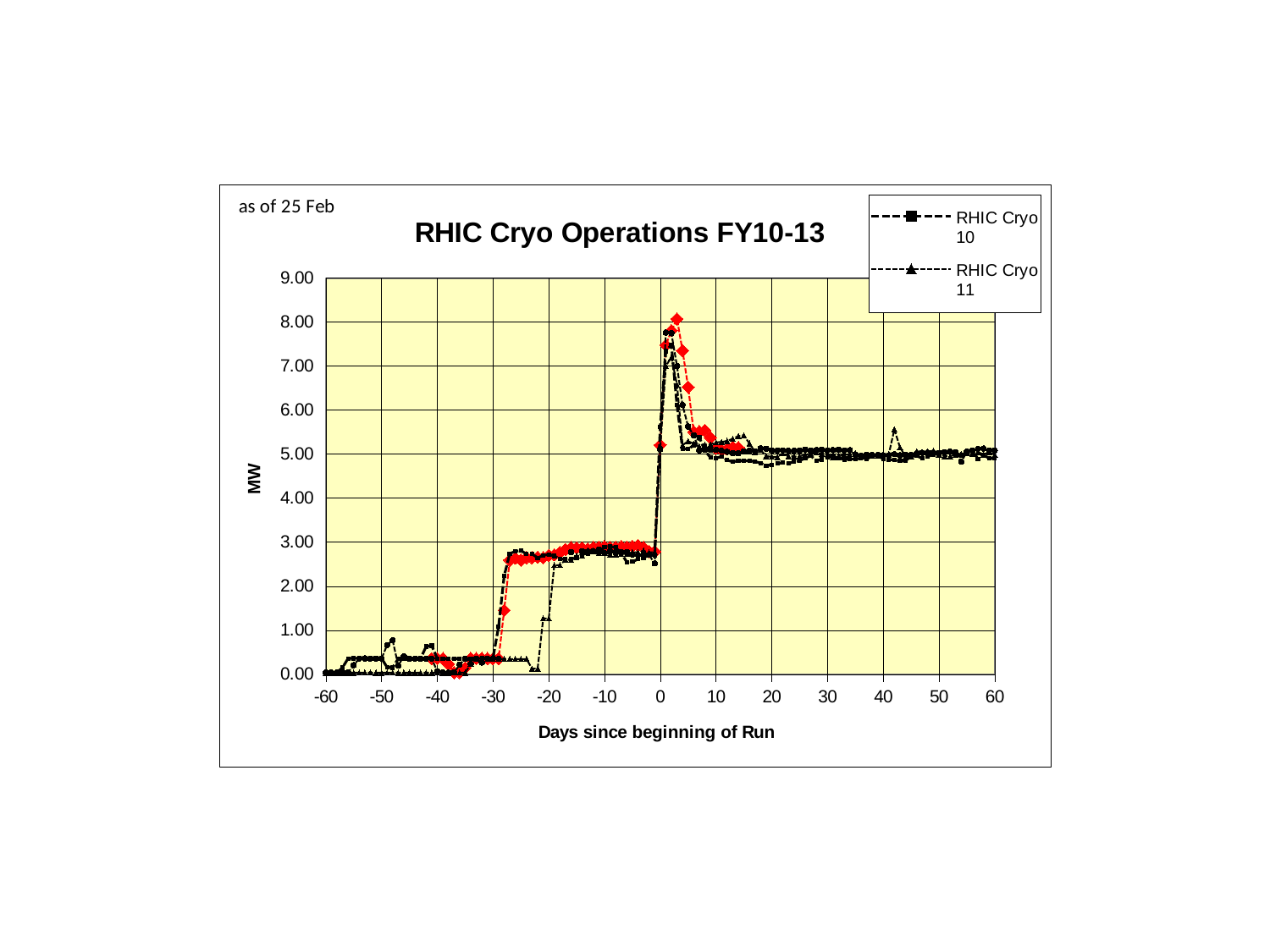
Is the value at day -50 greater or less than 1.00 MW? less Is the value at day 40 greater or less than 6.00 MW? less Do the values rise or fall between day 3 and day 20? fall What is the label of the y axis? MW Is the peak value reached shortly after day 0 greater or less than 7.00 MW? greater What is the highest value shown on the y axis? 9.00 What kind of chart is shown on the slide? line chart Do the values generally rise or fall between day -60 and day 0? rise What is the title of the chart? RHIC Cryo Operations FY10-13 What is the lowest value shown on the x axis? -60 How many series does the legend list? 2